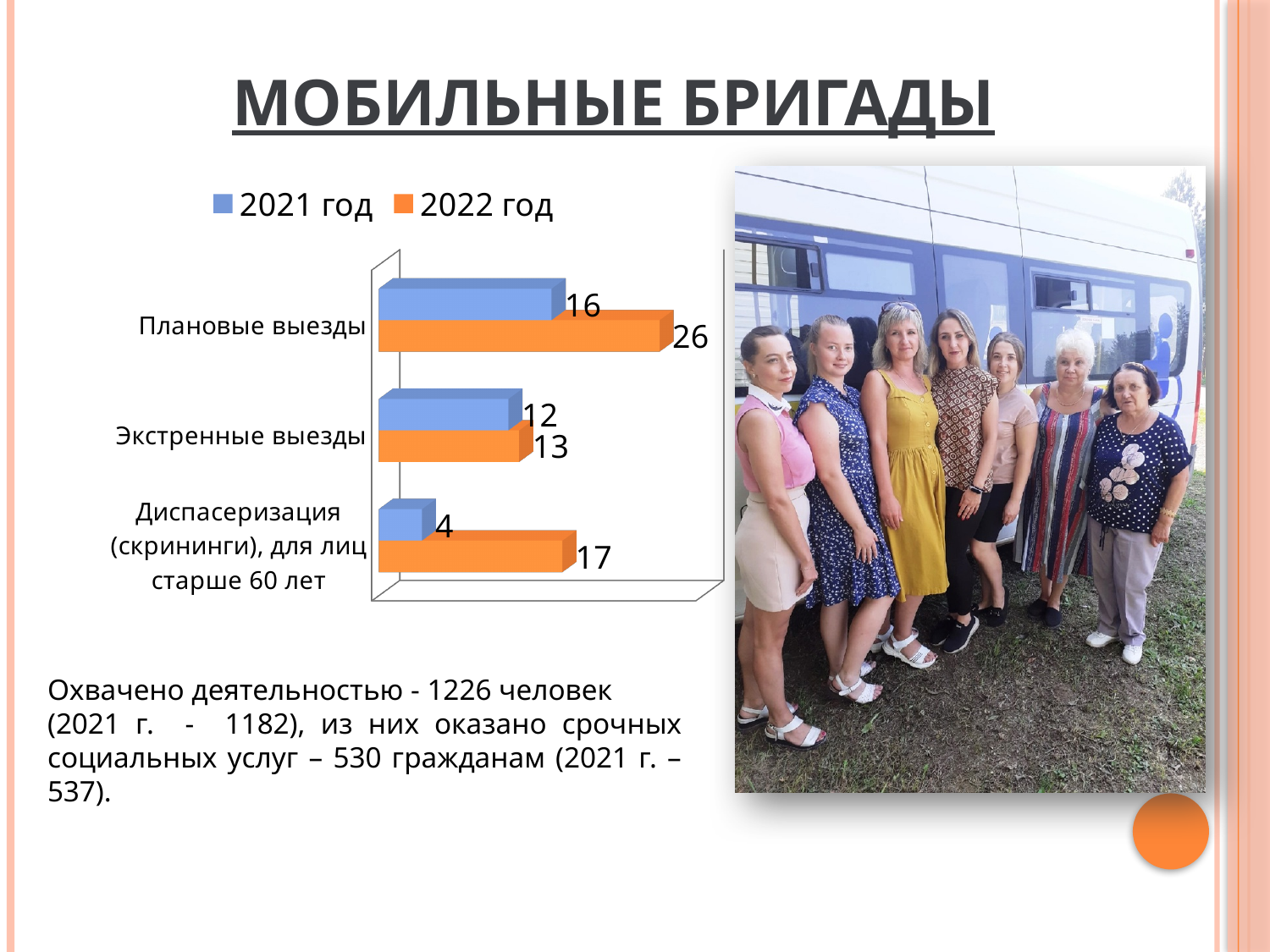
What is the value for Диспасеризация (скрининги), для лиц старше 60 лет in 2022 год? 17 Which category has the highest value in the 2022 год series? Плановые выезды What is the difference between the 2022 год and 2021 год values for Плановые выезды? 10 What kind of chart is shown on the slide? Bar chart What is the difference between the 2022 год and 2021 год values for Диспасеризация (скрининги), для лиц старше 60 лет? 13 Which is larger for Экстренные выезды: the 2021 год value or the 2022 год value? 2022 год How many categories are shown on the chart? 3 What is the value for Плановые выезды in 2022 год? 26 How many series does the legend list? 2 Which category has the lowest value in the 2021 год series? Диспасеризация (скрининги), для лиц старше 60 лет What is the value for Экстренные выезды in 2021 год? 12 Which colour represents the 2022 год series in the chart? Orange